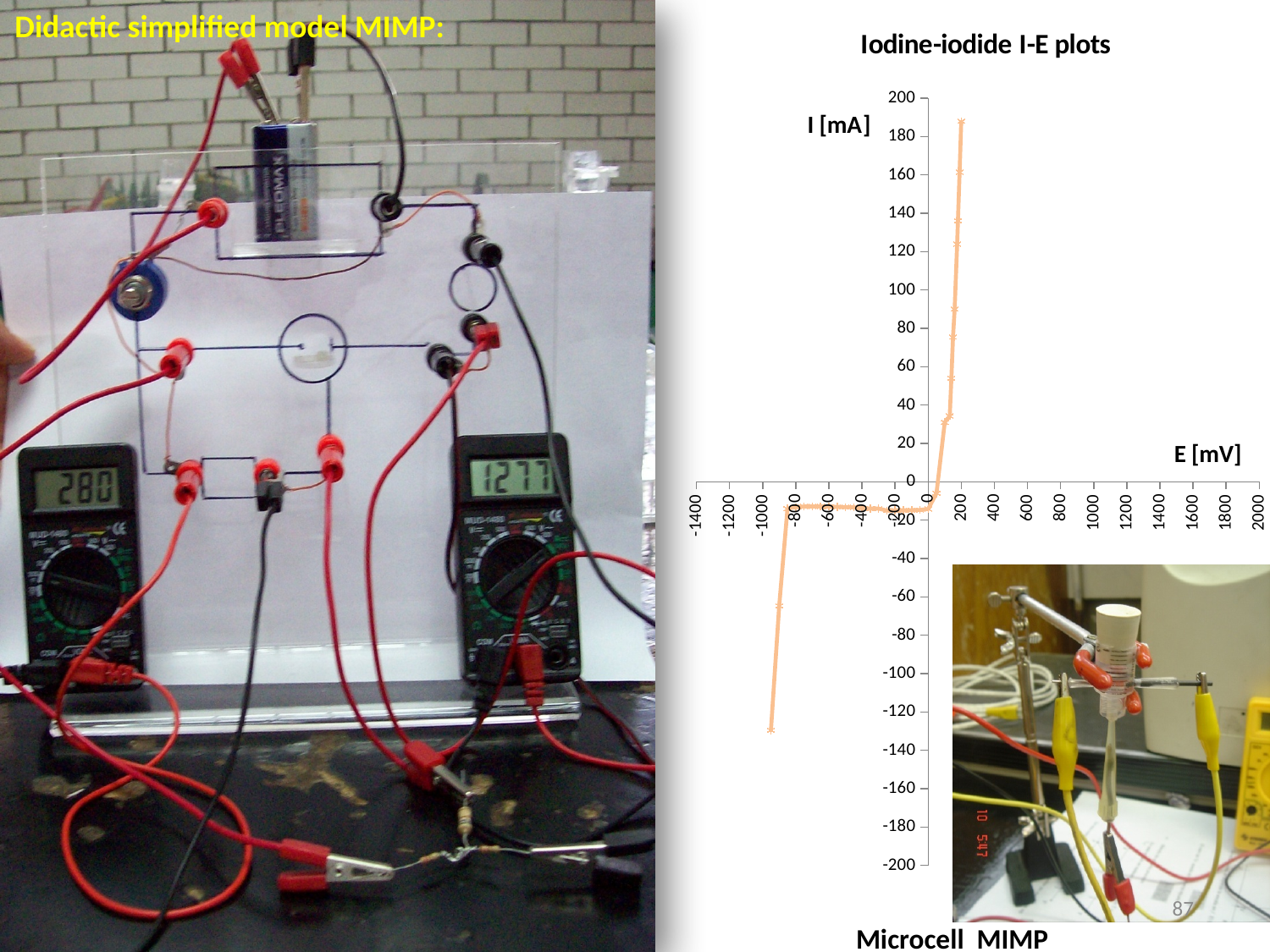
In the Iodine-iodide I-E plots chart, is the current at E = 0 mV greater or less than 100? less In the Iodine-iodide I-E plots chart, is the lowest plotted current value greater or less than -100? less What is the title of the chart on the slide? Iodine-iodide I-E plots In the Iodine-iodide I-E plots chart, which has the larger current: the point near E = 200 mV or the point near E = -1000 mV? the point near E = 200 mV What is the label of the horizontal axis in the Iodine-iodide I-E plots chart? E [mV] In the Iodine-iodide I-E plots chart, is the highest plotted current value greater or less than 160? greater In the Iodine-iodide I-E plots chart, does the current I rise or fall as the potential E increases along the x axis? rise What kind of chart is the Iodine-iodide I-E plots chart? line chart